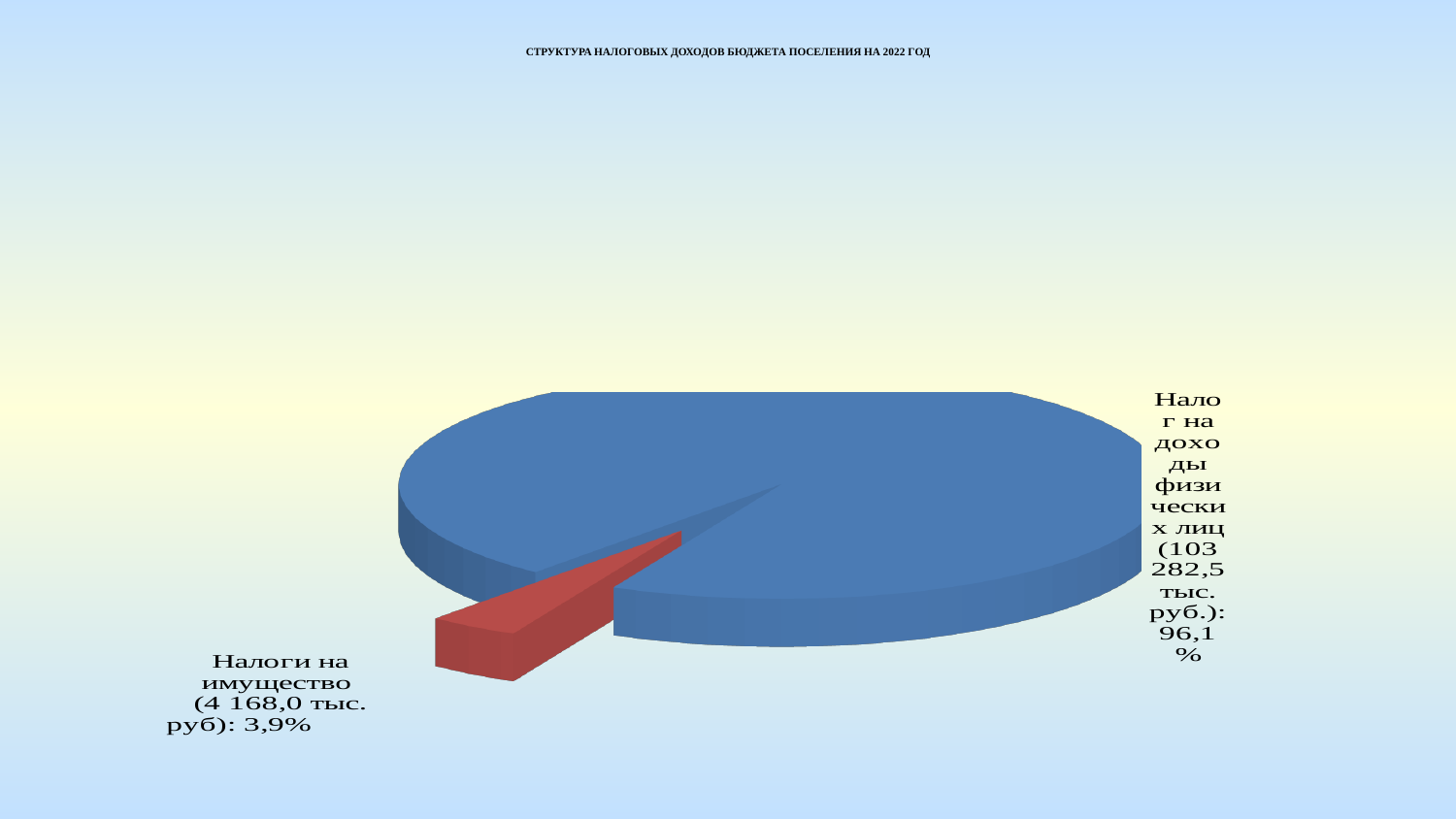
What is the difference in percentage points between the share of "Налог на доходы физических лиц" and the share of "Налоги на имущество"? 92,2 What is the value shown for "Налог на доходы физических лиц" in thousand rubles? 103 282,5 тыс. руб. How many slices does the pie chart have? 2 What share of the pie does "Налоги на имущество" represent? 3,9% What is the title of the chart? СТРУКТУРА НАЛОГОВЫХ ДОХОДОВ БЮДЖЕТА ПОСЕЛЕНИЯ НА 2022 ГОД Which category has the smallest slice of the pie? Налоги на имущество What is the value shown for "Налоги на имущество" in thousand rubles? 4 168,0 тыс. руб What kind of chart is shown on the slide? Pie chart Which category has the largest slice of the pie? Налог на доходы физических лиц What colour is the slice for "Налоги на имущество"? Red What share of the pie does "Налог на доходы физических лиц" represent? 96,1% Which is larger: the share for "Налог на доходы физических лиц" or the share for "Налоги на имущество"? Налог на доходы физических лиц